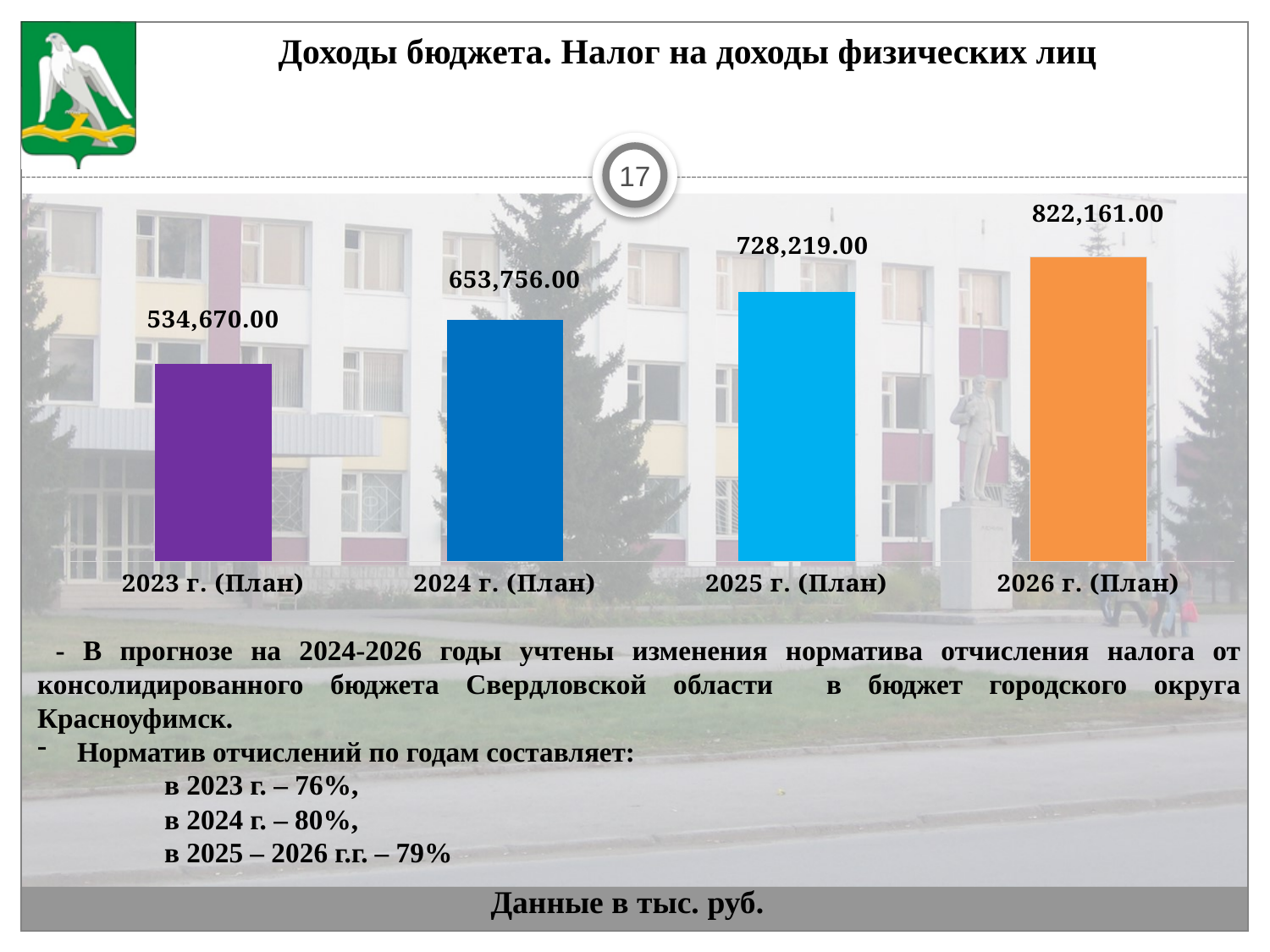
Which year has the highest value? 2026 г. (План) What is the value for 2024 г. (План)? 653,756.00 How many bars are shown in the chart? 4 Do the values rise or fall from 2023 to 2026? Rise What is the difference between the values for 2026 г. (План) and 2025 г. (План)? 93,942.00 Which year has the lowest value? 2023 г. (План) Which is larger, the value for 2025 г. (План) or the value for 2024 г. (План)? 2025 г. (План) What is the value for 2025 г. (План)? 728,219.00 What kind of chart is shown on the slide? Bar chart What is the value for 2026 г. (План)? 822,161.00 What is the value for 2023 г. (План)? 534,670.00 What is the difference between the values for 2024 г. (План) and 2023 г. (План)? 119,086.00